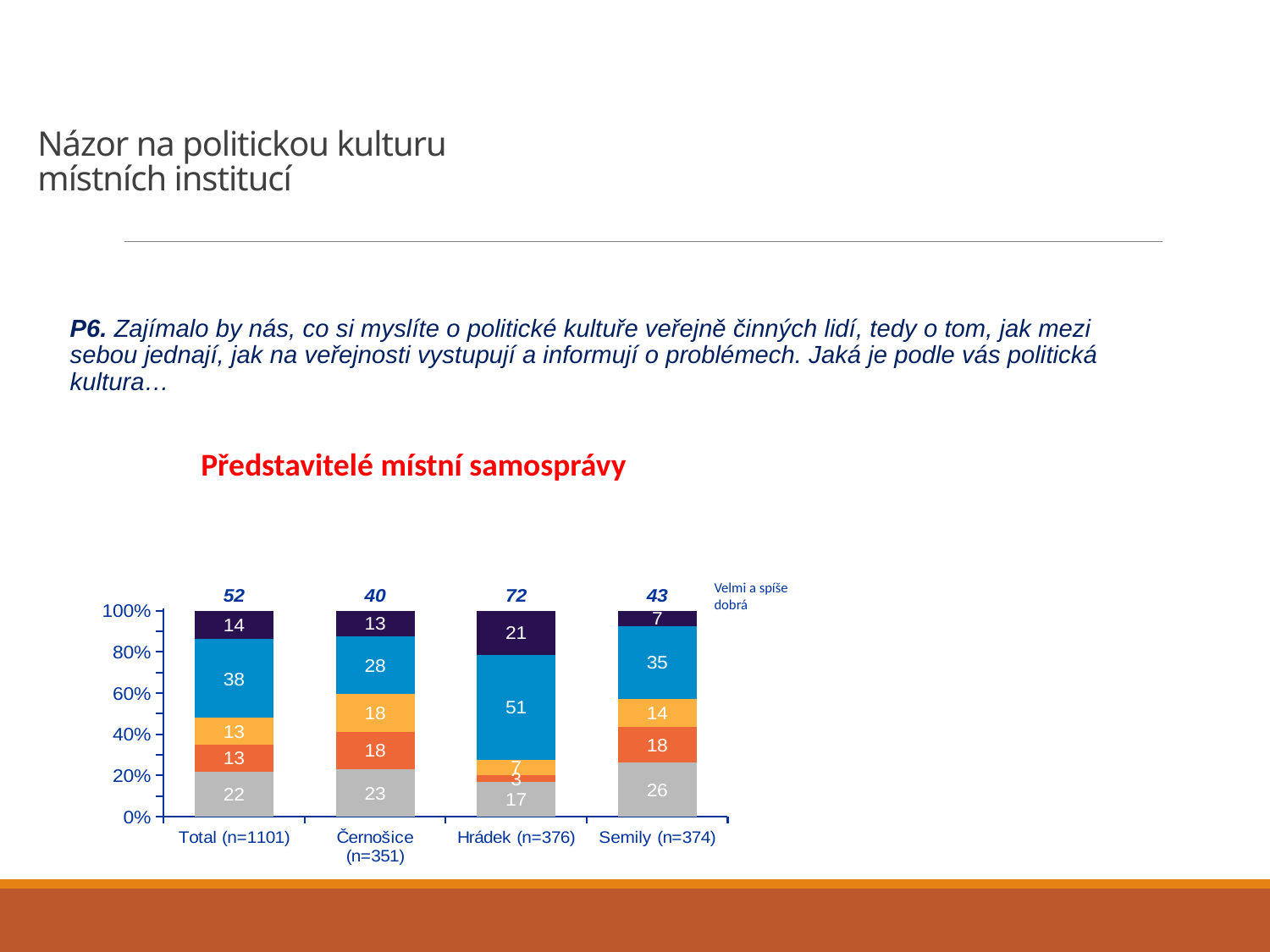
What is the value of the light blue segment for Hrádek (n=376)? 51 What is the difference between the grey segment values for Semily (n=374) and Hrádek (n=376)? 9 Which category has the highest 'Velmi a spíše dobrá' value shown above the bars? Hrádek (n=376) What is the title shown in red above the chart? Představitelé místní samosprávy What is the value of the grey bottom segment for Semily (n=374)? 26 What is the value of the orange segment for Černošice (n=351)? 18 Which category has the smallest dark navy top segment? Semily (n=374) Which is larger: the light blue segment for Total (n=1101) or for Semily (n=374)? Total (n=1101) What is the difference between the 'Velmi a spíše dobrá' values for Hrádek (n=376) and Černošice (n=351)? 32 How many categories are shown on the x axis of the chart? 4 What kind of chart is shown on the slide? Stacked bar chart What is the 'Velmi a spíše dobrá' value shown above the bar for Total (n=1101)? 52